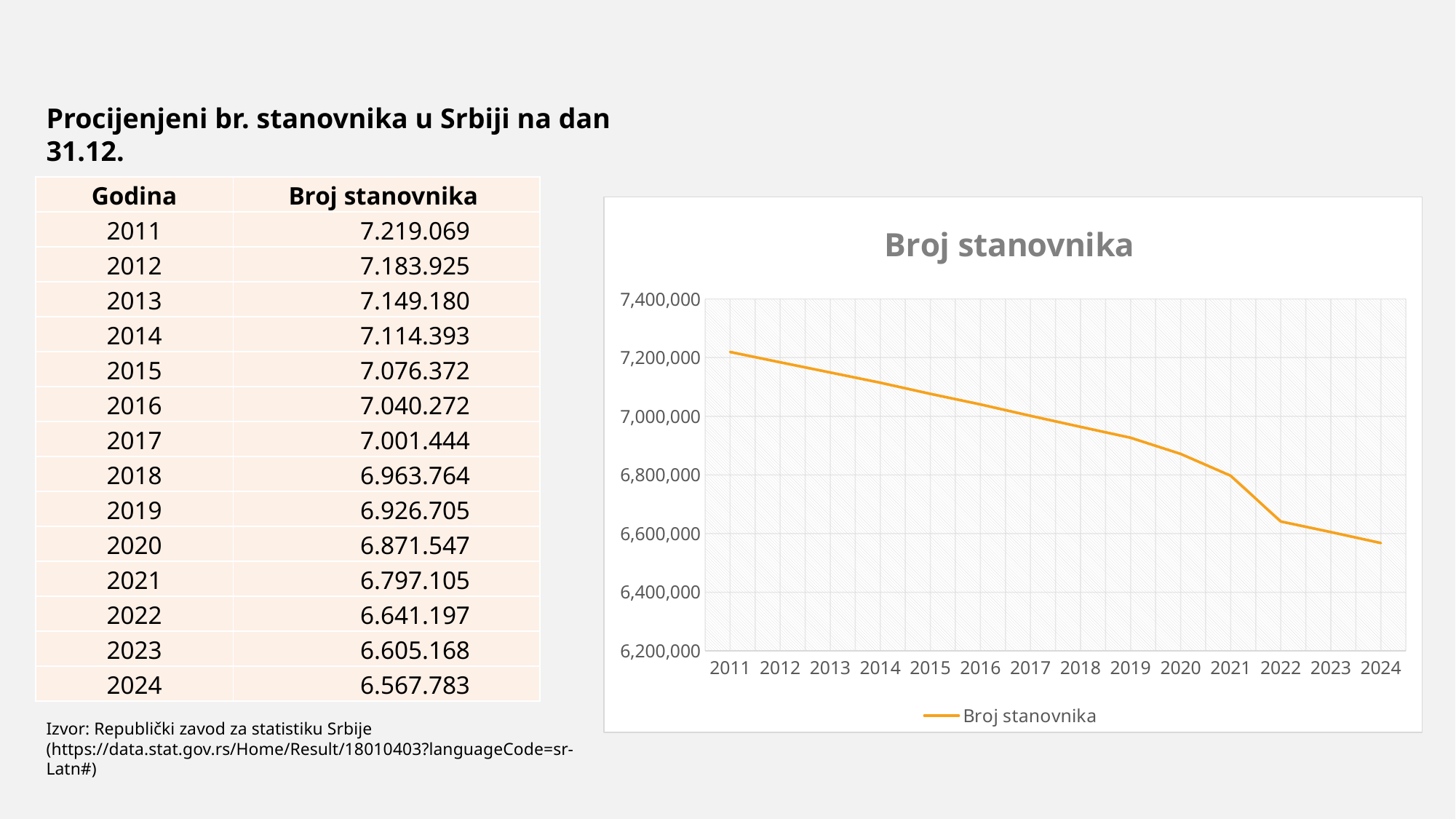
Is the value for 2016 greater or less than 7,000,000? greater Is the value for 2021 greater or less than 7,000,000? less How many years are plotted on the x axis of the chart? 14 What is the title of the chart? Broj stanovnika Does the number of inhabitants rise or fall from 2011 to 2024 in the chart? fall Is the value for 2024 greater or less than 6,600,000? less How many series does the chart legend list? 1 Which year has the highest value in the chart? 2011 What kind of chart is shown on the slide? line chart What is the value for 2011 shown on the slide? 7.219.069 Which year has the lowest value in the chart? 2024 Which is larger, the value for 2019 or the value for 2022? 2019